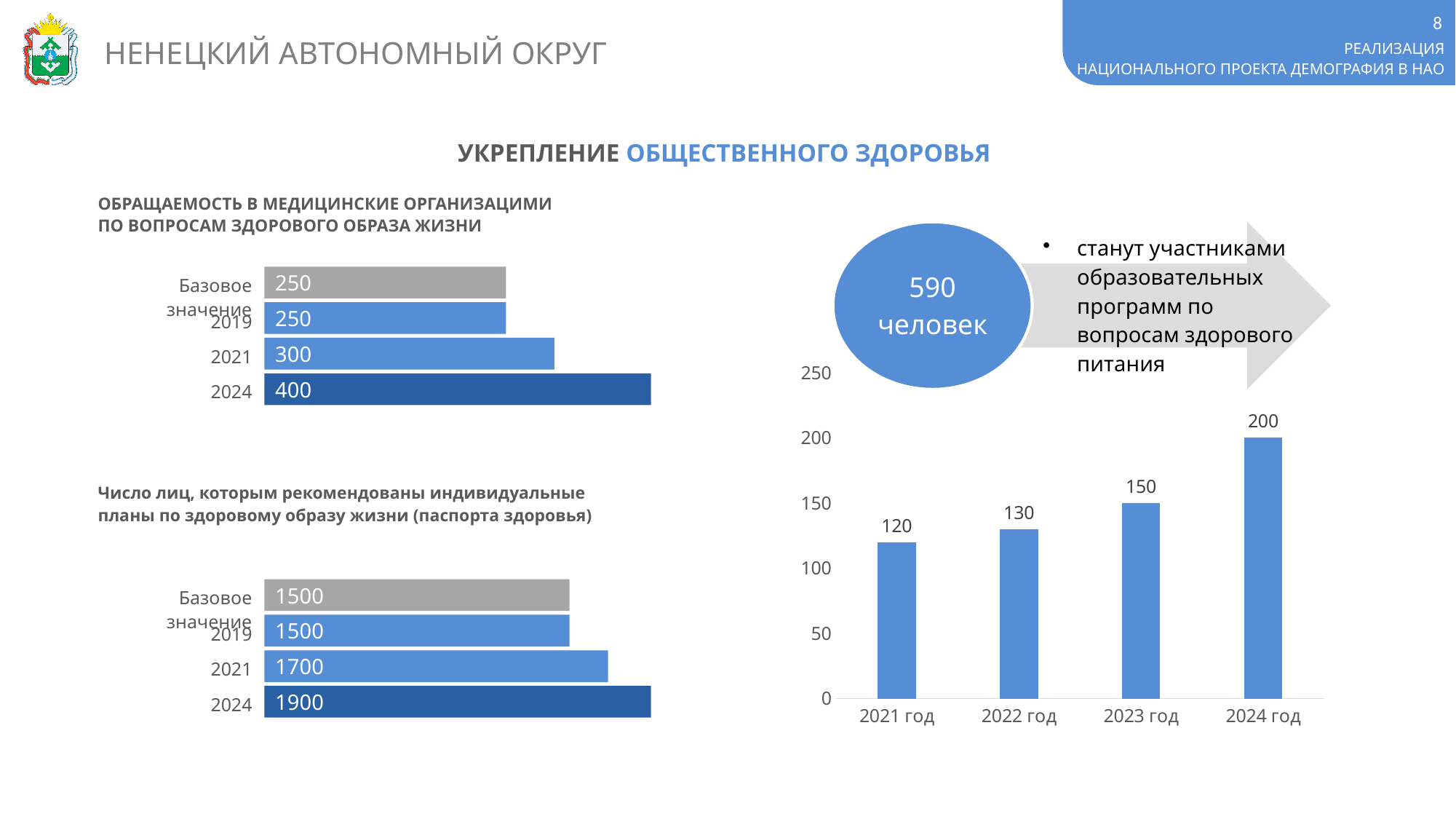
In the top-left chart (Обращаемость в медицинские организации), how many bars are plotted? 4 In the top-left chart (Обращаемость в медицинские организации по вопросам здорового образа жизни), what is the value for 2024? 400 In the top-left chart (Обращаемость в медицинские организации), what is the difference between the 2024 value and the Базовое значение? 150 What kind of chart is the bottom-left chart (Число лиц, которым рекомендованы индивидуальные планы)? bar chart In the bottom-left chart (Число лиц, которым рекомендованы индивидуальные планы), which category has the highest value? 2024 In the right-hand chart with years 2021 год to 2024 год, what is the value for 2023 год? 150 In the bottom-left chart (Число лиц, которым рекомендованы индивидуальные планы по здоровому образу жизни), what is the value for 2021? 1700 In the right-hand chart with years 2021 год to 2024 год, what is the difference between the 2024 год and 2022 год values? 70 In the right-hand chart with years 2021 год to 2024 год, which year has the lowest value? 2021 год In the top-left chart (Обращаемость в медицинские организации), what is the value for 2021? 300 In the bottom-left chart (Число лиц, которым рекомендованы индивидуальные планы), what is the difference between the 2024 and 2019 values? 400 In the right-hand chart with years 2021 год to 2024 год, do the values rise or fall from 2021 год to 2024 год? rise